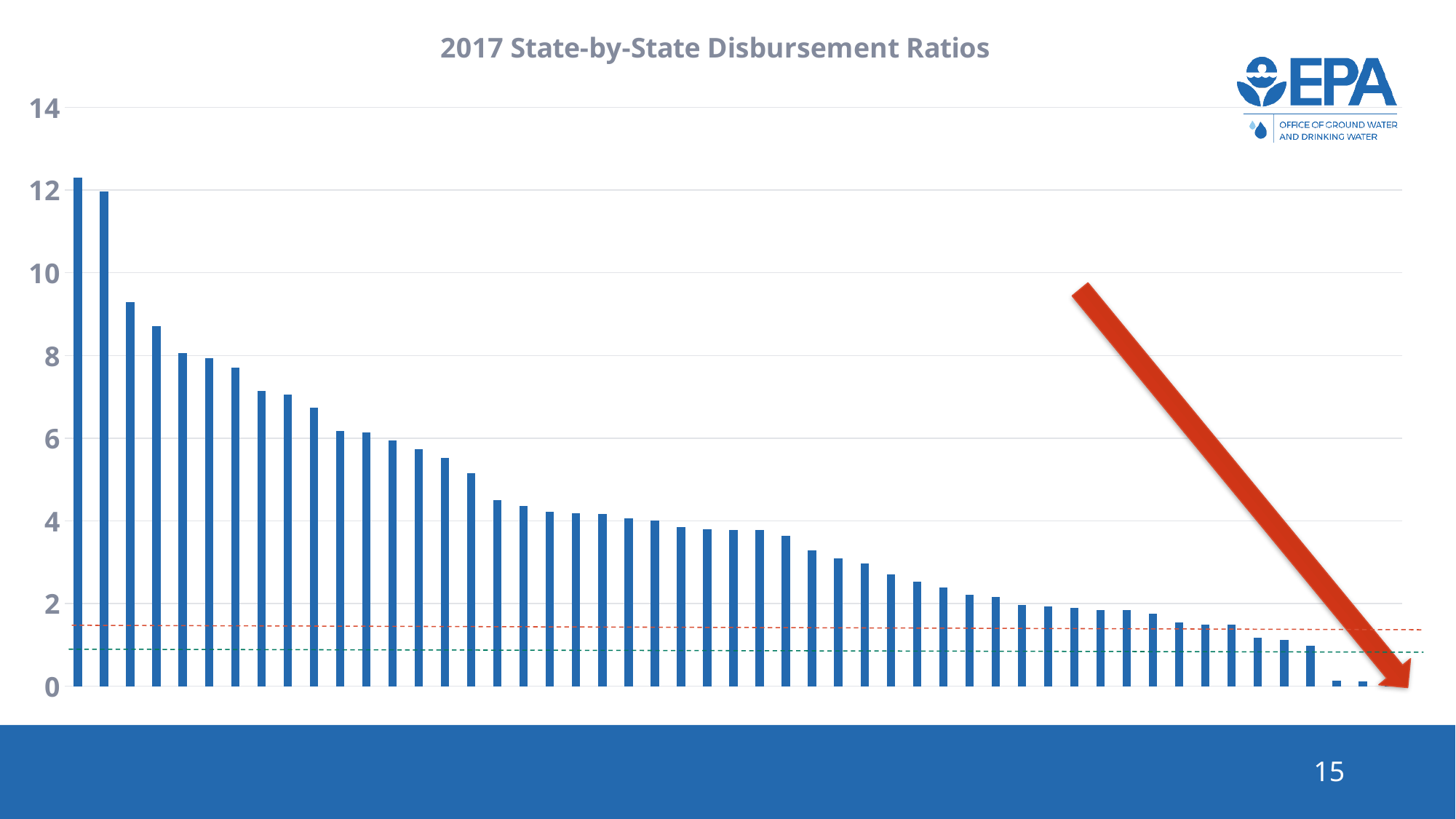
Is the value of the third bar from the left greater or less than 10? less Is the value of the tallest (leftmost) bar greater or less than 10? greater Is the value of the rightmost bar greater or less than 2? less What kind of chart is shown on the slide? bar chart Do the bar values rise or fall from left to right across the chart? fall What colour are the bars in the chart? blue Which bar is taller, the leftmost bar or the rightmost bar? the leftmost bar What is the title of the chart? 2017 State-by-State Disbursement Ratios What is the highest value shown on the vertical axis? 14 Where on the chart is the tallest bar located? at the far left